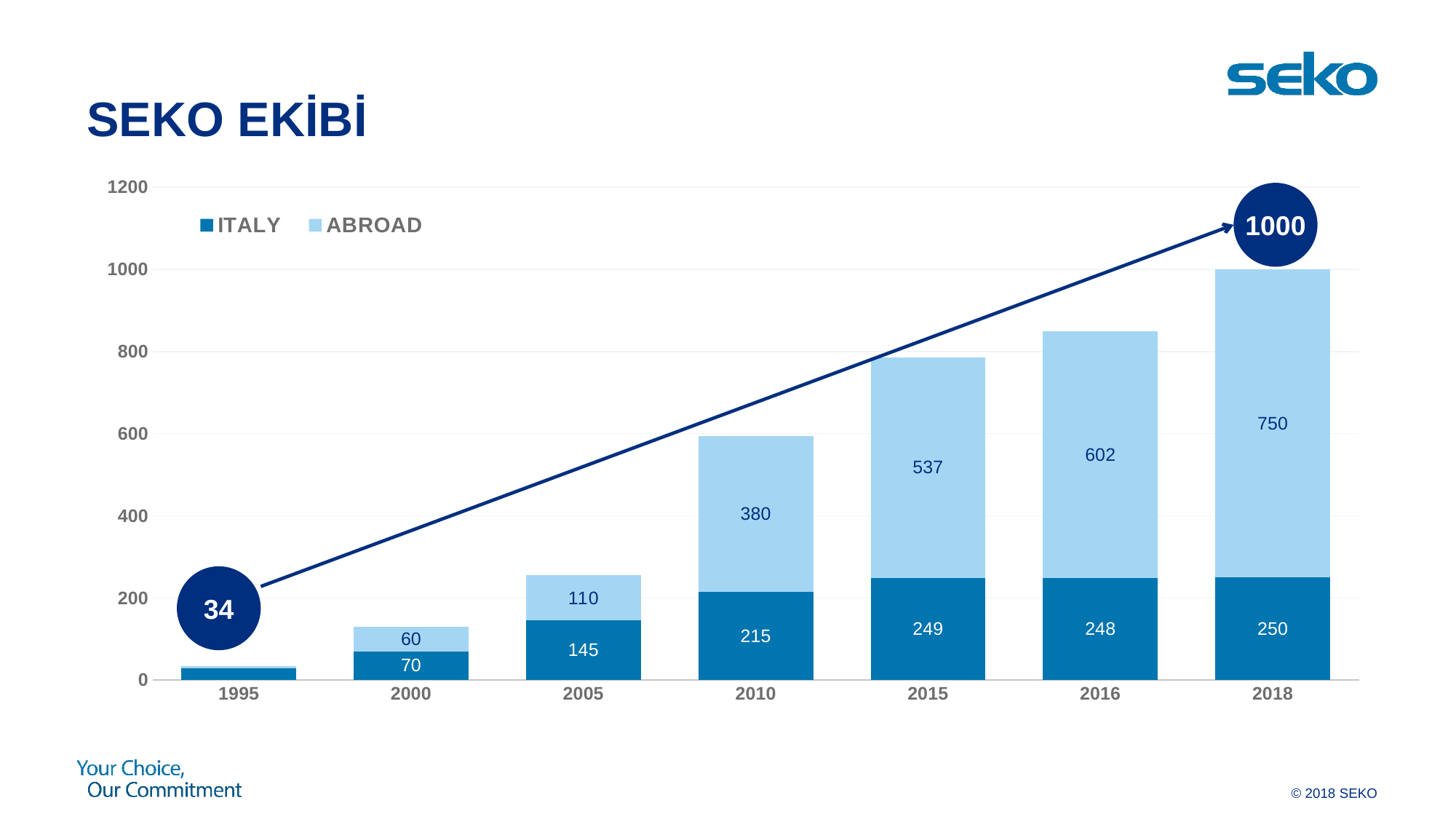
What is the total of the stacked bar for 2005? 255 What is the difference between the ABROAD values for 2018 and 2015? 213 What is the ABROAD value for 2005? 110 What is the ITALY value for 2010? 215 What kind of chart is shown on the slide? Stacked bar chart What is the ABROAD value for 2016? 602 How many years are shown on the x axis? 7 What is the total of the stacked bar for 2018? 1000 Is the total for 2016 greater or less than 800? greater How many series does the legend list? 2 Which year has the highest ABROAD value? 2018 Which is larger in 2010, the ITALY value or the ABROAD value? ABROAD